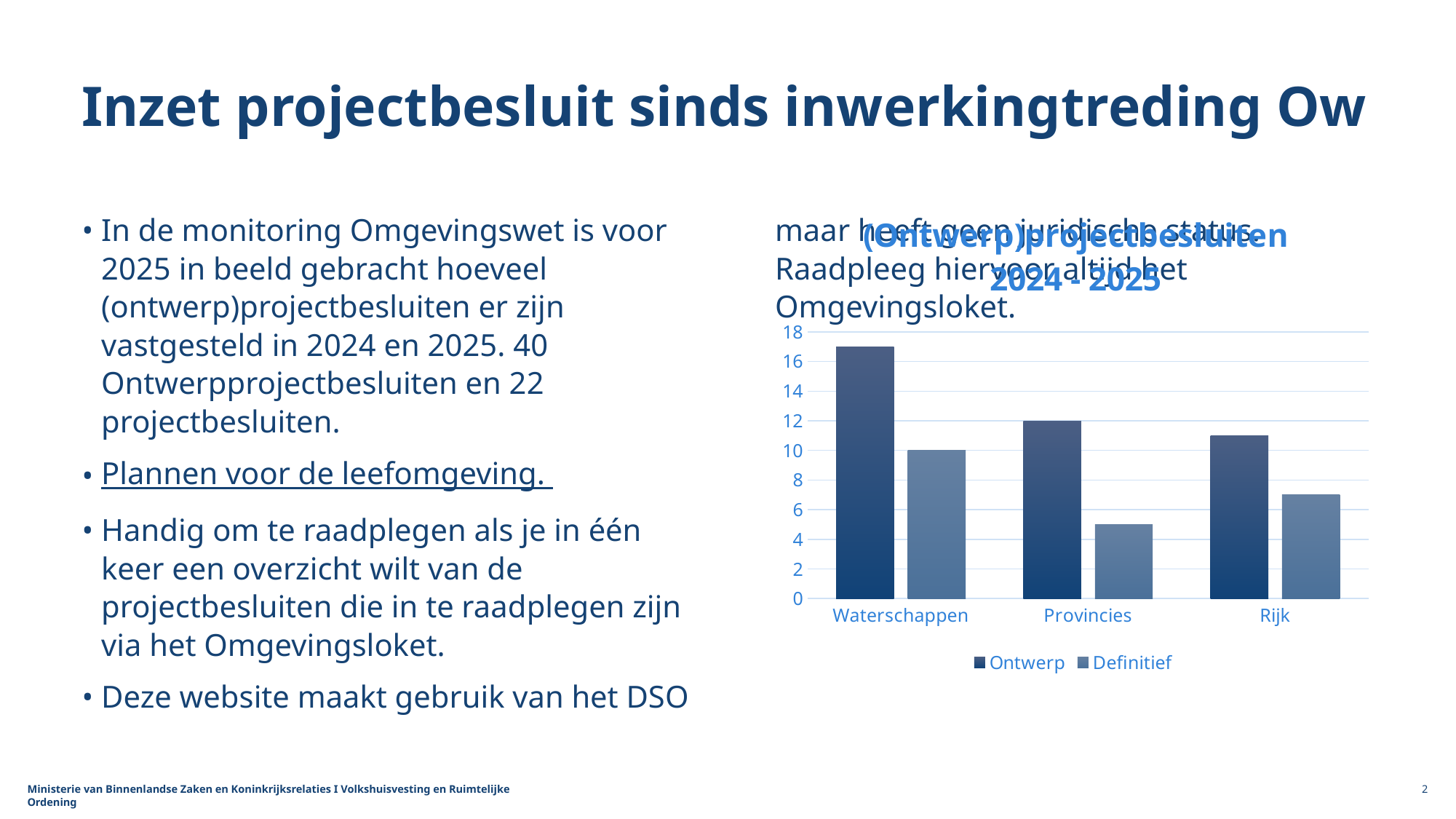
How many categories are shown on the x axis of the chart? 3 How many series does the chart legend list? 2 Is the Ontwerp value for Waterschappen greater or less than 16? greater What is the Ontwerp value for Provincies? 12 What kind of chart is shown on the slide? bar chart What is the title of the chart? (Ontwerp)projectbesluiten 2024 - 2025 Is the Definitief value for Provincies greater or less than 6? less Which category has the lowest Definitief value? Provincies Is the Definitief value for Rijk greater or less than 6? greater Which is larger: the Definitief value for Waterschappen or the Definitief value for Rijk? Waterschappen Which category has the highest Ontwerp value? Waterschappen What is the Definitief value for Waterschappen? 10